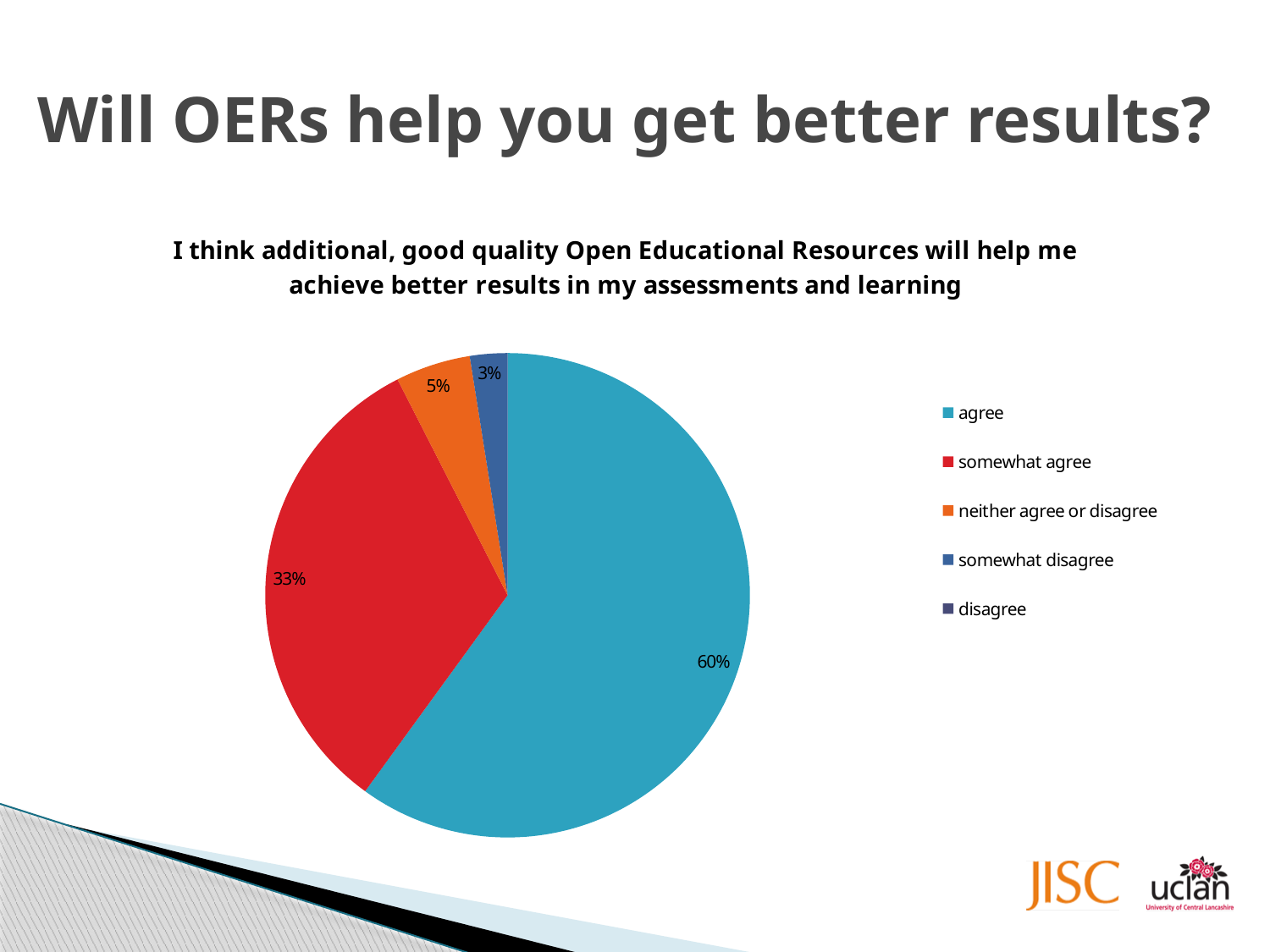
What is the combined share of "agree" and "somewhat agree"? 93% What kind of chart is shown on the slide? pie chart What is the title of the chart? I think additional, good quality Open Educational Resources will help me achieve better results in my assessments and learning How many entries does the legend list? 5 What is the difference in percentage points between "agree" and "somewhat agree"? 27 What colour is the "agree" slice? blue Which response has the largest share of the pie? agree What percentage of respondents chose "neither agree or disagree"? 5% What percentage of respondents chose "agree"? 60% Which is larger, the share for "neither agree or disagree" or the share for "somewhat disagree"? neither agree or disagree What percentage of respondents chose "somewhat agree"? 33% What percentage of respondents chose "somewhat disagree"? 3%